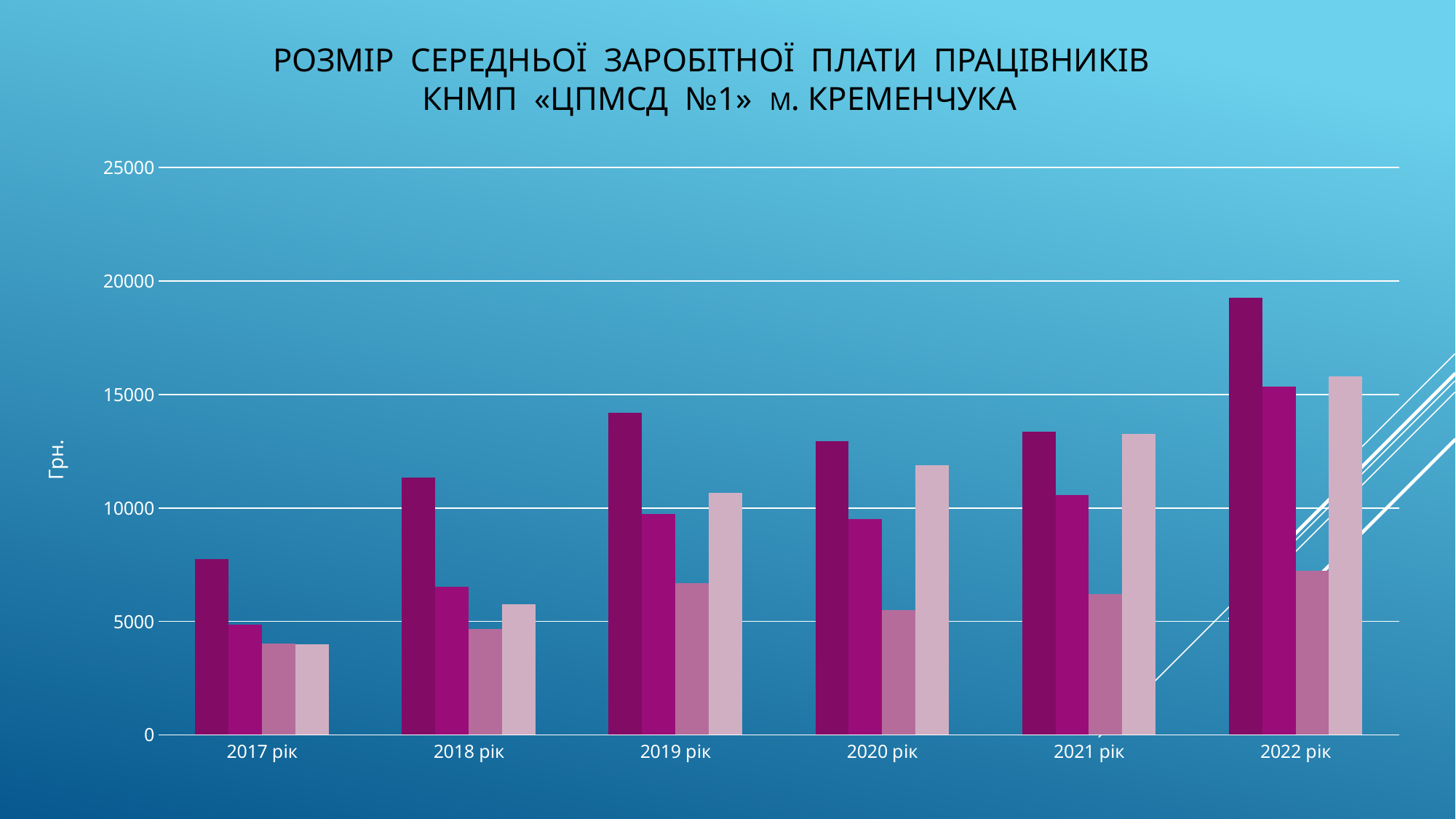
Is the tallest (darkest) bar for 2022 рік greater or less than 15000? greater Do the lightest pink bars rise or fall from 2017 рік to 2022 рік? rise How many years (categories) are shown on the x axis? 6 What label is shown on the vertical axis? Грн. What kind of chart is shown on the slide? bar chart Is the lightest pink bar for 2017 рік greater or less than 5000? less How many bars are plotted for each year? 4 Is the darkest bar for 2017 рік greater or less than 5000? greater Which year has the tallest bar in the chart? 2022 рік What is the highest value shown on the vertical axis? 25000 Which is larger: the darkest bar for 2019 рік or the darkest bar for 2020 рік? 2019 рік